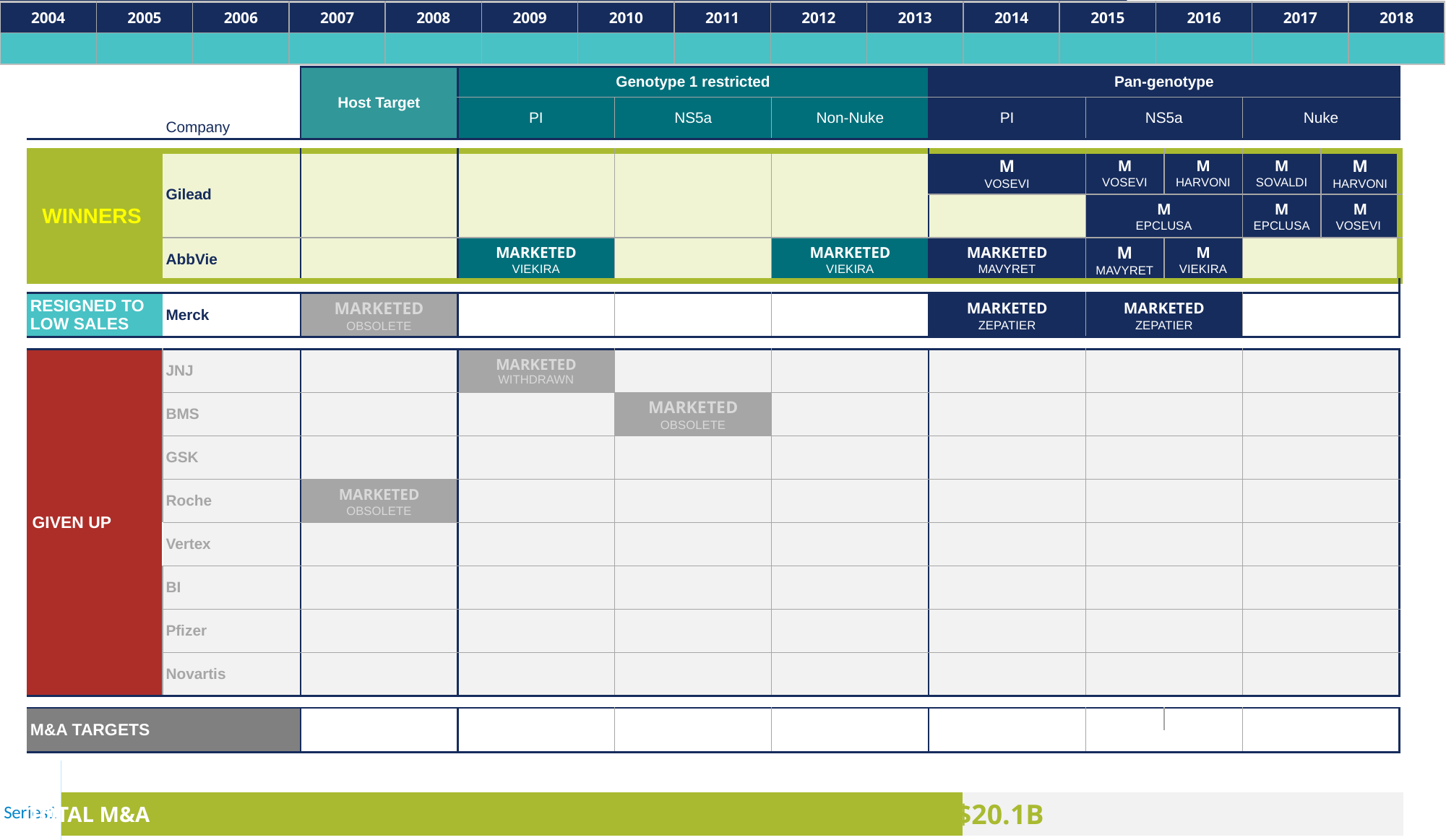
Is the value of the bar at the bottom of the slide greater or less than $20B? greater How many bars are plotted in the chart at the bottom of the slide? 2 What value is printed on the green bar at the bottom of the slide? $20.1B What series label appears at the left end of the bar at the bottom of the slide? Series1 What kind of chart is shown at the bottom of the slide, below the M&A TARGETS row? bar chart